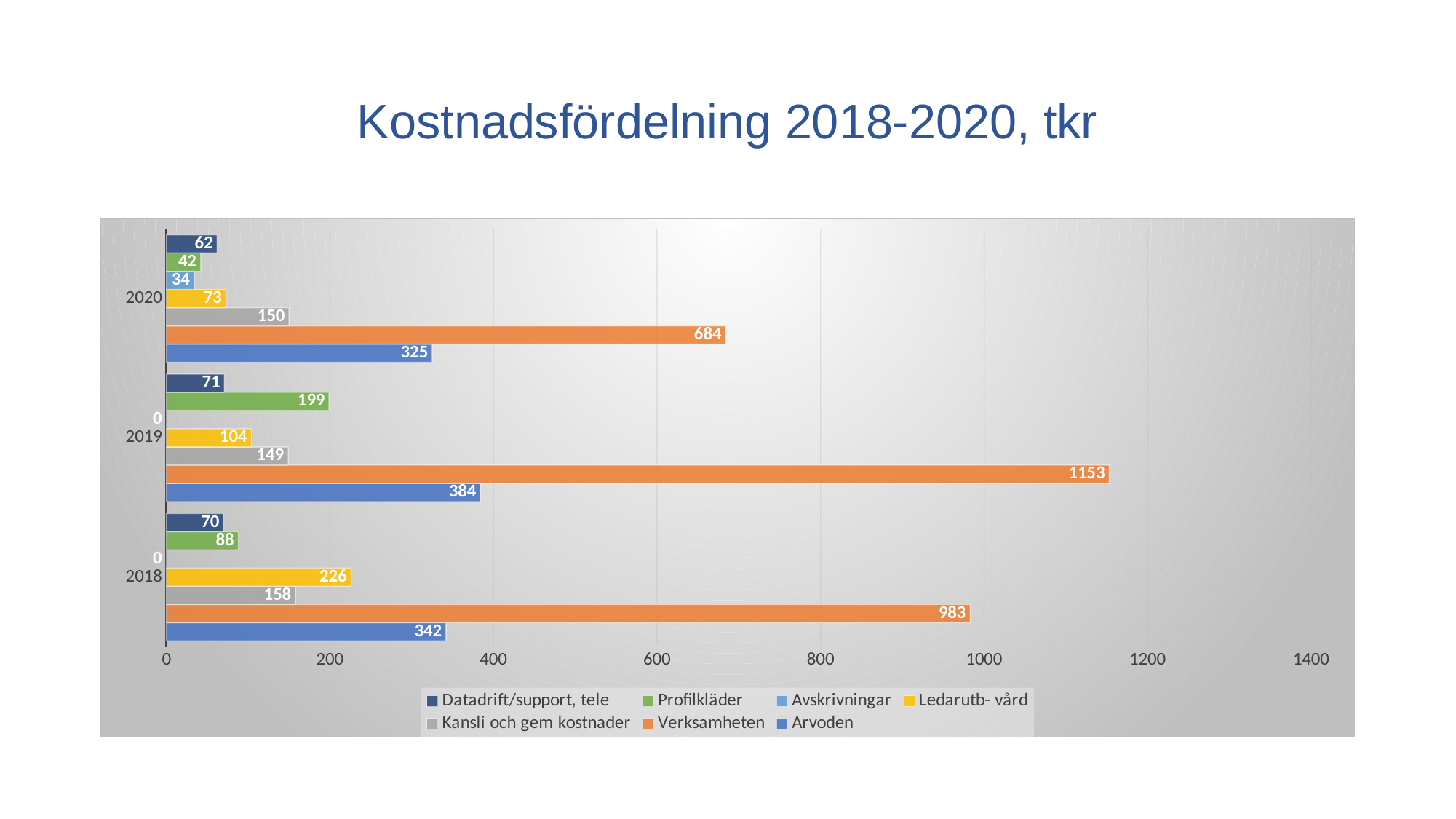
What is the value for Verksamheten in 2019? 1153 Which is larger: Profilkläder in 2019 or Profilkläder in 2018? Profilkläder in 2019 What is the difference between Verksamheten in 2019 and Verksamheten in 2020? 469 What is the value for Avskrivningar in 2020? 34 What is the title of the chart? Kostnadsfördelning 2018-2020, tkr How many years are shown on the vertical axis? 3 Which series has the lowest value in 2020? Avskrivningar What is the value for Arvoden in 2020? 325 What is the value for Ledarutb- vård in 2018? 226 How many series does the legend list? 7 What kind of chart is shown on the slide? Bar chart Which series has the highest value in 2018? Verksamheten